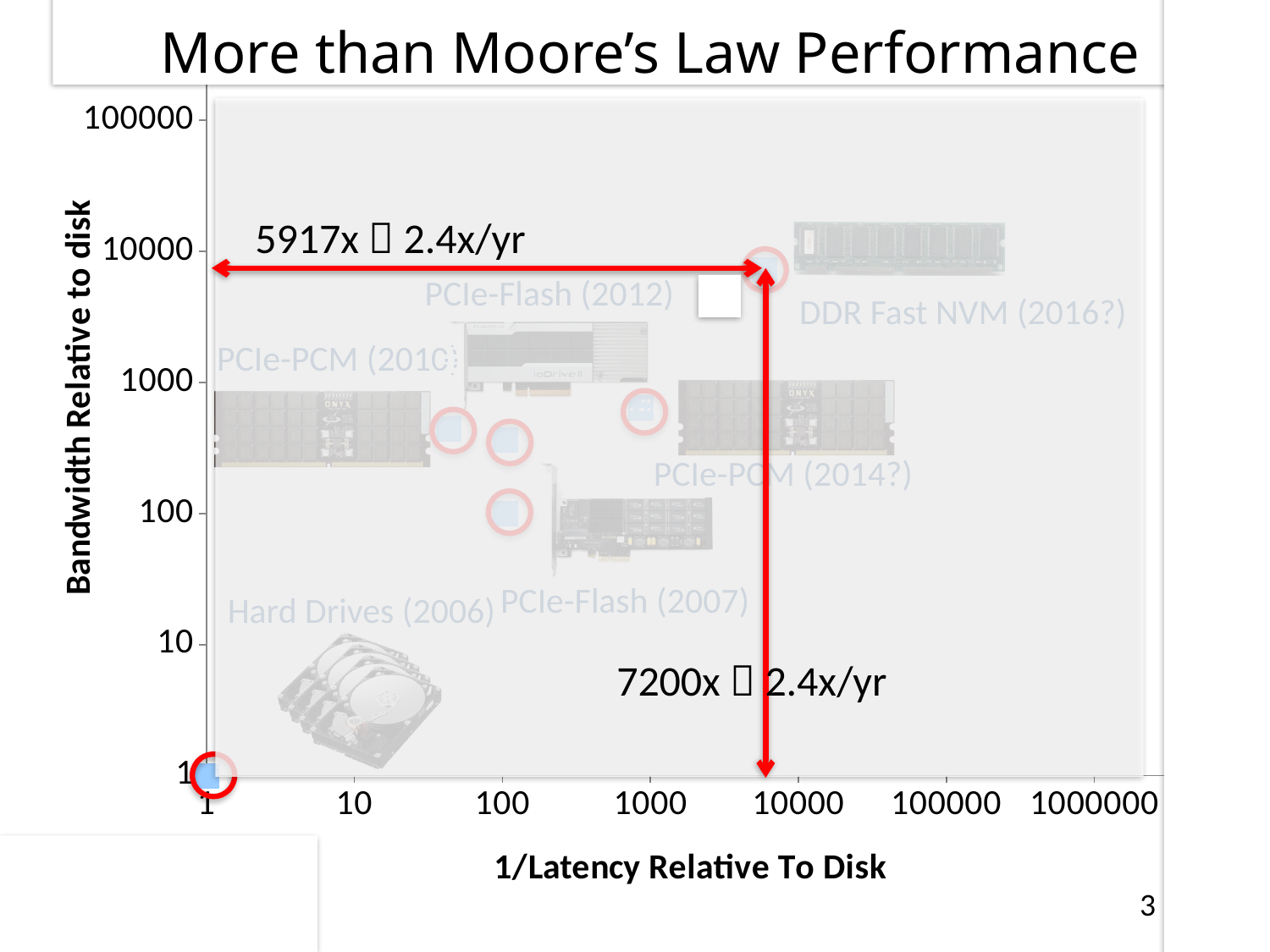
What is the label of the horizontal axis? 1/Latency Relative To Disk What latency improvement factor is annotated on the horizontal red arrow? 5917x What kind of chart is shown on the slide? scatter chart How many circled data points are plotted on the chart? 6 What bandwidth improvement factor is annotated on the vertical red arrow? 7200x Which labelled technology has the highest bandwidth relative to disk? DDR Fast NVM (2016?) What is the label of the vertical axis? Bandwidth Relative to disk Is the bandwidth relative to disk for DDR Fast NVM (2016?) greater or less than 1000? greater Which labelled technology has the lowest bandwidth relative to disk? Hard Drives (2006) What is the bandwidth relative to disk for Hard Drives (2006)? 1 What annual growth rate is annotated next to the 7200x factor? 2.4x/yr What is the title of the chart on the slide? More than Moore's Law Performance